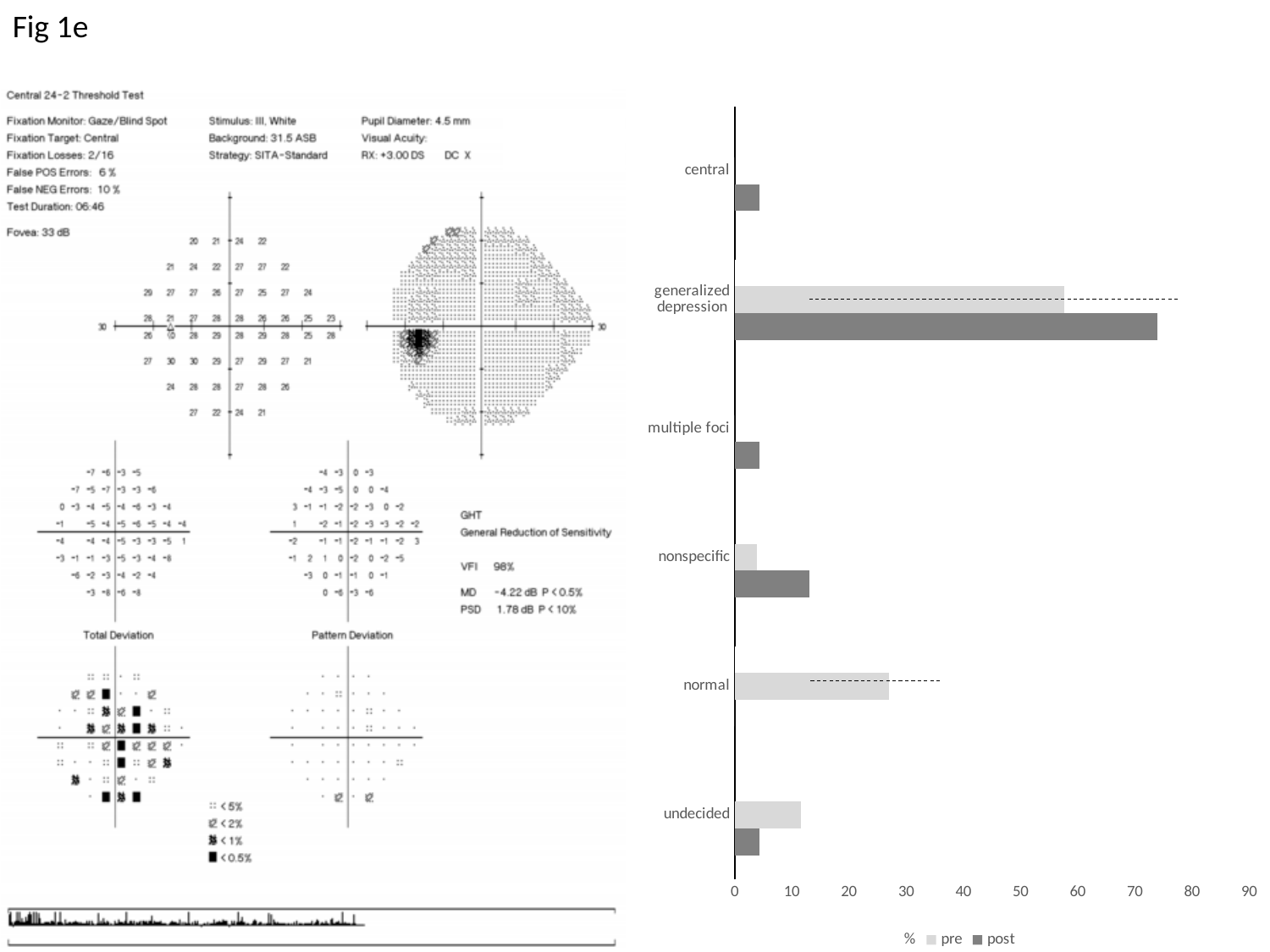
Is the pre value for normal greater or less than 20? greater For generalized depression, which is larger, the pre value or the post value? post Is the post value for generalized depression greater or less than 70? greater Which category has the highest pre value in the bar chart? generalized depression What kind of chart is shown on the right side of the slide? bar chart Is the post value for nonspecific greater or less than 20? less For undecided, which is larger, the pre value or the post value? pre Which category has the highest post value in the bar chart? generalized depression How many categories are shown on the bar chart's vertical axis? 6 How many series does the legend of the bar chart list? 3